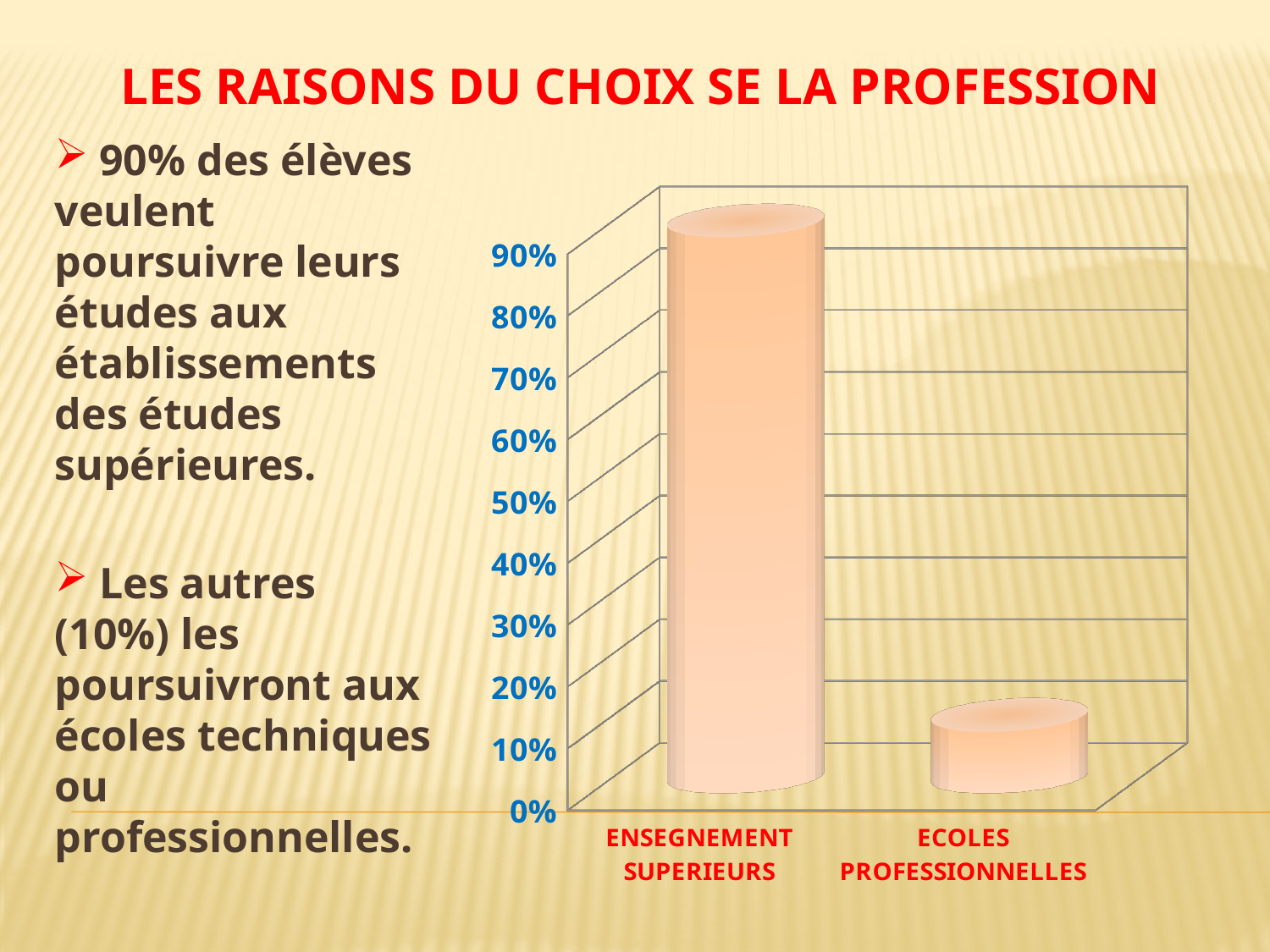
Is the value for ENSEGNEMENT SUPERIEURS greater or less than 80%? greater Do the bar values rise or fall from left to right along the x axis? fall Which category has the highest bar in the chart? ENSEGNEMENT SUPERIEURS How many categories are shown on the x axis of the chart? 2 What kind of chart is shown on the slide? bar chart Is the value for ECOLES PROFESSIONNELLES greater or less than 20%? less Which category has the lowest bar in the chart? ECOLES PROFESSIONNELLES What is the highest tick label shown on the vertical axis of the chart? 90% What is the lowest tick label shown on the vertical axis of the chart? 0% Is the value for ECOLES PROFESSIONNELLES greater or less than 50%? less Which is larger, the bar for ENSEGNEMENT SUPERIEURS or the bar for ECOLES PROFESSIONNELLES? ENSEGNEMENT SUPERIEURS